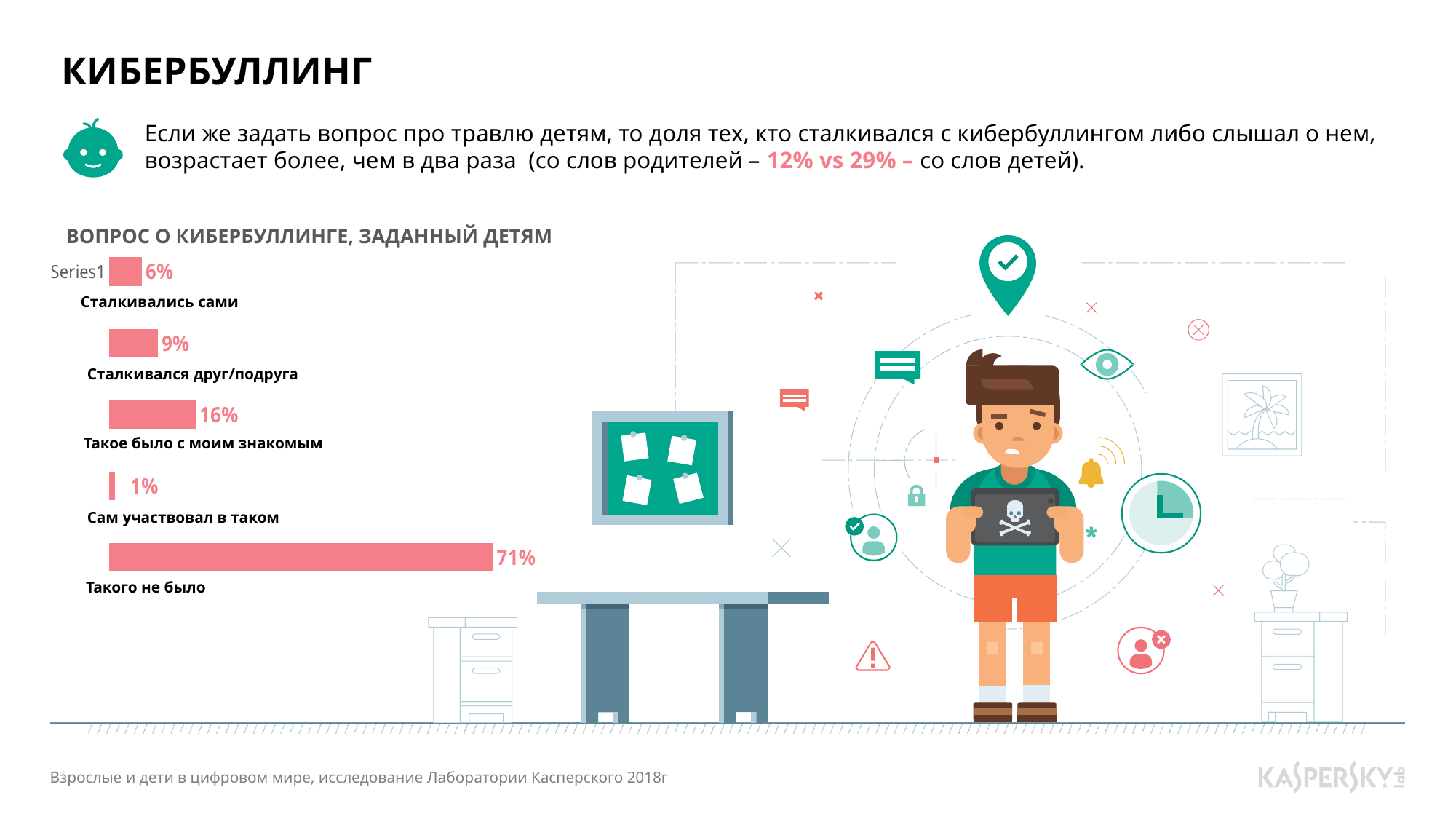
What is the value for 'Сталкивался друг/подруга'? 9% What kind of chart is shown on the slide? bar chart Which is larger: 'Сталкивался друг/подруга' or 'Сталкивались сами'? Сталкивался друг/подруга What is the value for 'Такого не было'? 71% Which category has the lowest value? Сам участвовал в таком What is the value for 'Такое было с моим знакомым'? 16% Which category has the highest value? Такого не было What is the value for 'Сталкивались сами'? 6% What is the difference between 'Такое было с моим знакомым' and 'Сталкивались сами'? 10% What is the title of the chart? ВОПРОС О КИБЕРБУЛЛИНГЕ, ЗАДАННЫЙ ДЕТЯМ How many categories does the chart show? 5 What is the value for 'Сам участвовал в таком'? 1%